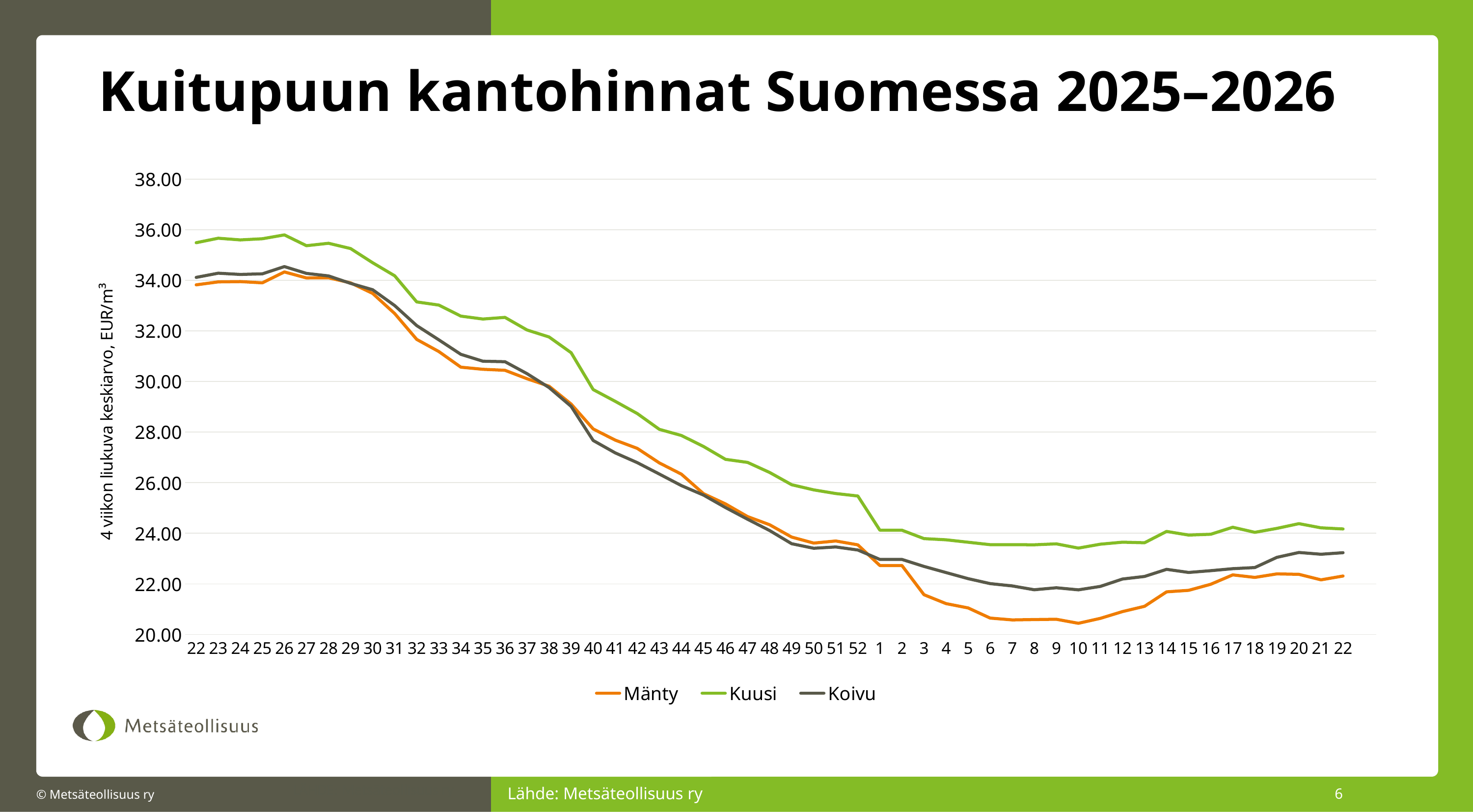
Does the Mänty series rise or fall from week 22 to week 10? fall Is the value for Koivu at week 52 greater or less than 24.00? less Which series has the lowest value at week 10? Mänty Which series has the highest value at week 40? Kuusi Which series are listed in the legend? Mänty, Kuusi, Koivu What kind of chart is shown on the slide? line chart How many series does the legend list? 3 Is the value for Kuusi at week 52 greater or less than 24.00? greater Is the value for Mänty at week 10 greater or less than 22.00? less What is the title of the chart? Kuitupuun kantohinnat Suomessa 2025–2026 How many week points are plotted along the x axis? 53